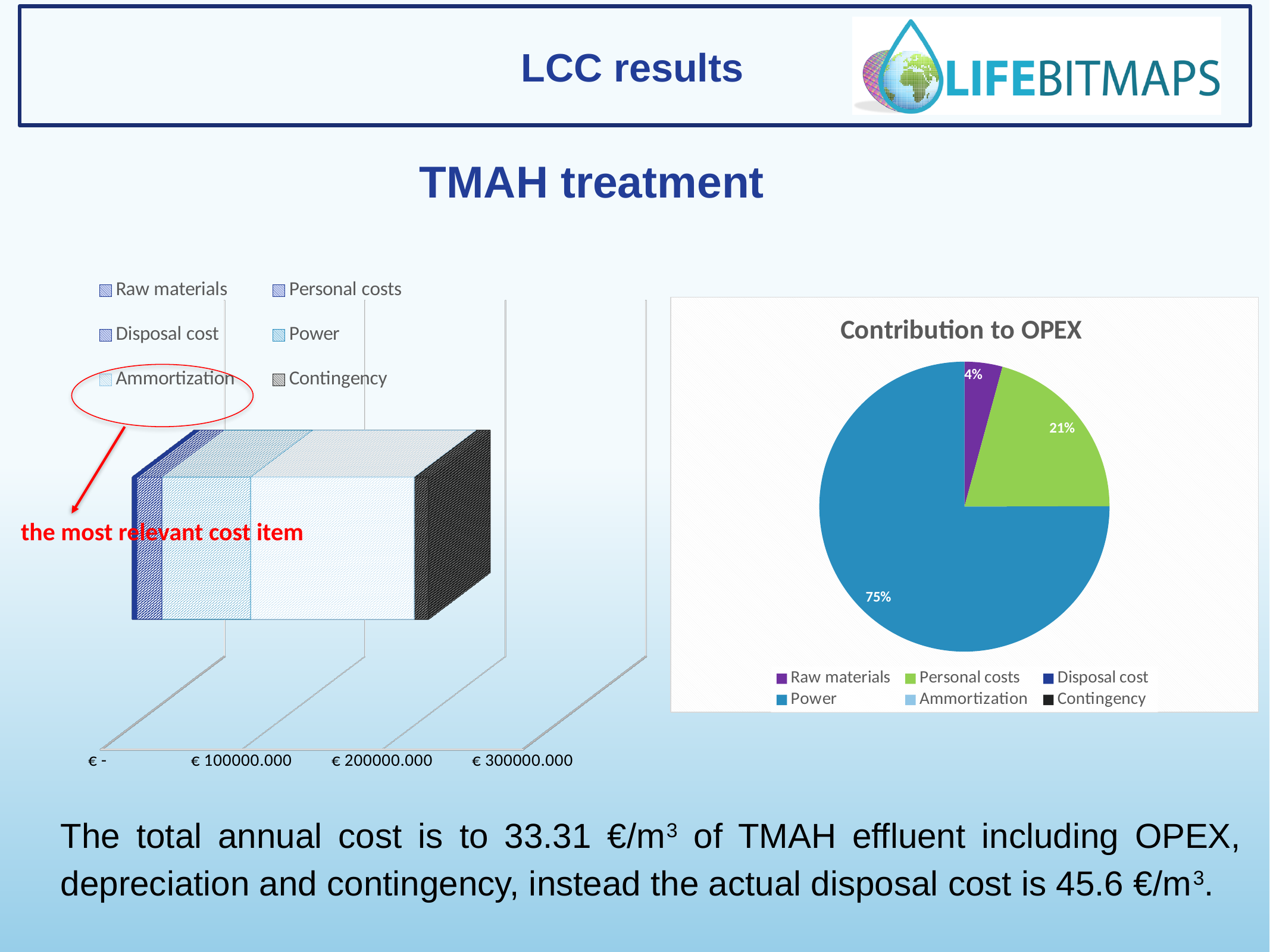
In the 'Contribution to OPEX' pie chart, what share does Personal costs contribute? 21% In the 'Contribution to OPEX' pie chart, what share does Power contribute? 75% In the 'Contribution to OPEX' pie chart, which is larger: the Personal costs share or the Raw materials share? Personal costs In the 'Contribution to OPEX' pie chart, which category has the largest slice? Power How many entries does the legend of the 'Contribution to OPEX' chart list? 6 In the 'Contribution to OPEX' pie chart, how many percentage points larger is the Power share than the Personal costs share? 54 In the bar chart on the left, which cost item is identified as the most relevant (largest) segment? Ammortization In the bar chart on the left, is the total length of the stacked bar greater or less than € 100000.000? greater What kind of chart is the chart on the left of the slide? Bar chart What kind of chart is the chart on the right of the slide? Pie chart In the 'Contribution to OPEX' pie chart, what share does Raw materials contribute? 4% In the 'Contribution to OPEX' pie chart, which of the labelled slices is the smallest? Raw materials